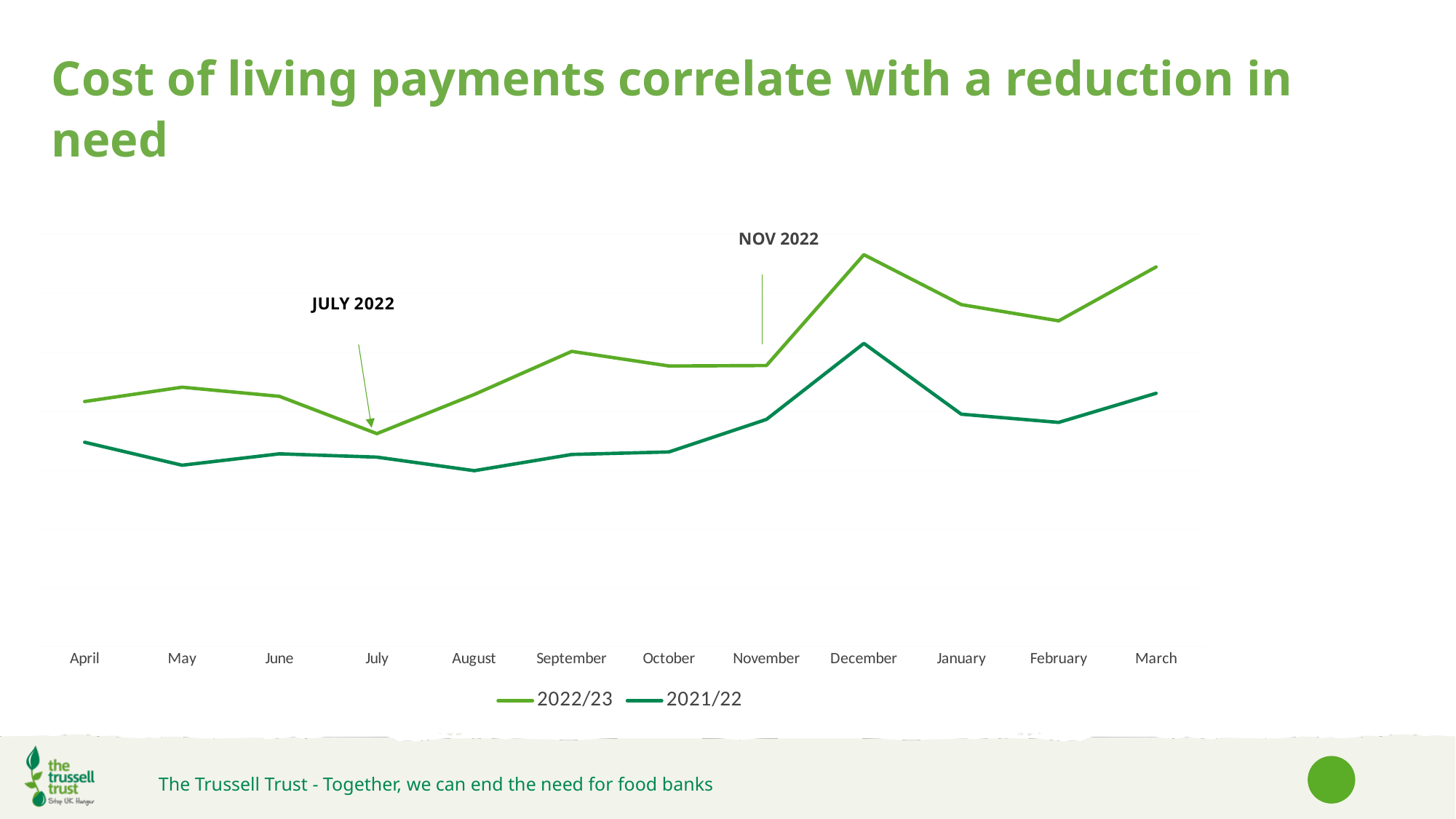
Which series is drawn in the darker green line? 2021/22 In which month is the 2022/23 line at its lowest? July What kind of chart is shown on the slide? Line chart How many series does the legend list? 2 Which two dates are annotated on the chart? JULY 2022 and NOV 2022 Does the 2022/23 line rise or fall between November and December? Rise How many months are shown along the x axis? 12 In December, which series has the higher value, 2022/23 or 2021/22? 2022/23 Does the 2022/23 line rise or fall between December and February? Fall In which month is the 2021/22 line at its lowest? August In which month does the 2021/22 line reach its highest point? December In which month does the 2022/23 line reach its highest point? December